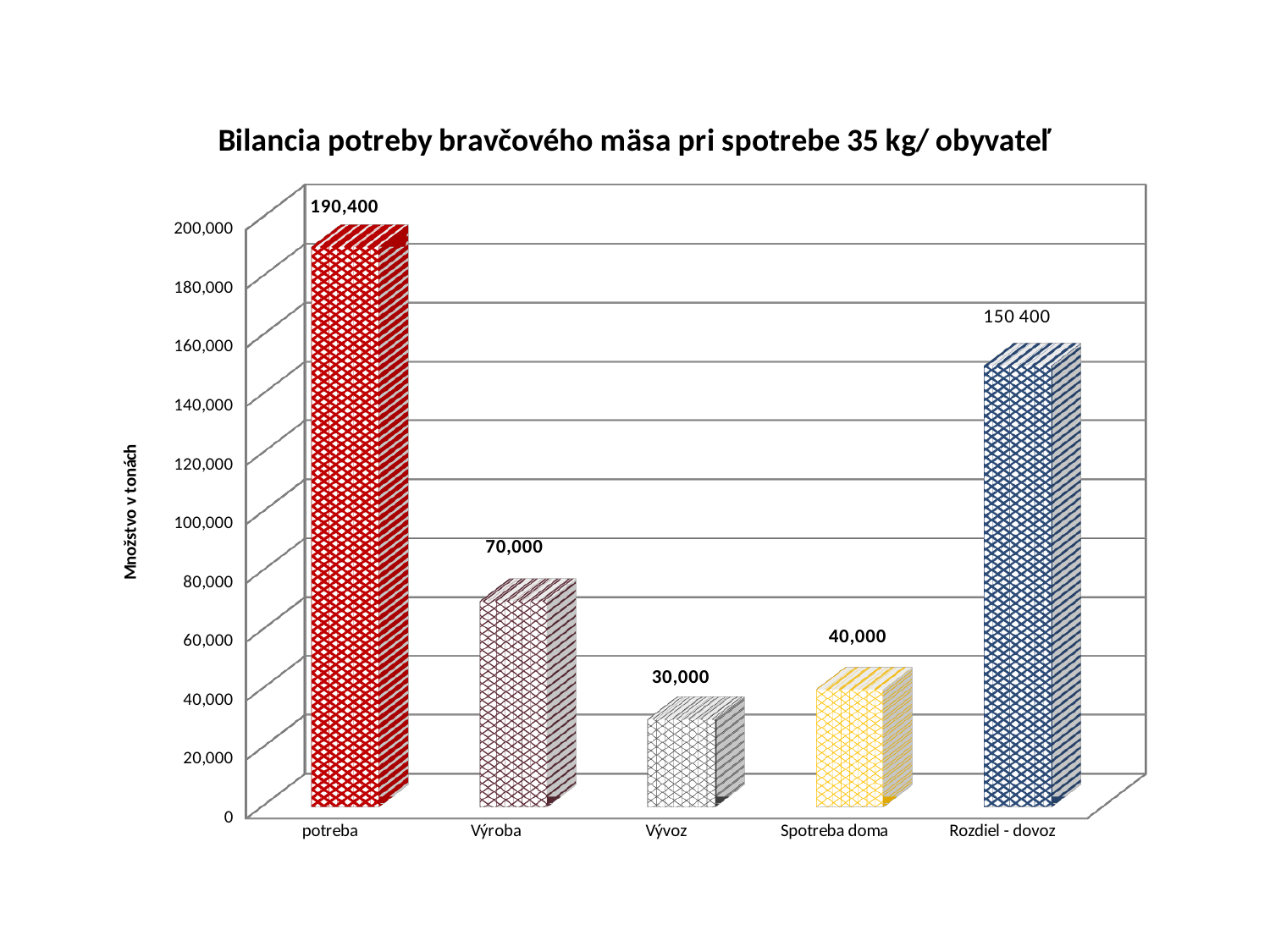
What kind of chart is shown on the slide? bar chart What is the value for Výroba? 70,000 What is the value for potreba? 190,400 What is the value for Spotreba doma? 40,000 What is the title of the chart? Bilancia potreby bravčového mäsa pri spotrebe 35 kg/ obyvateľ Which category has the lowest value? Vývoz How many categories are shown on the x axis? 5 What is the value for Vývoz? 30,000 Which is larger, the value for Spotreba doma or the value for Vývoz? Spotreba doma What is the value for Rozdiel - dovoz? 150 400 Which category has the highest value? potreba What is the difference between the values for Výroba and Vývoz? 40,000